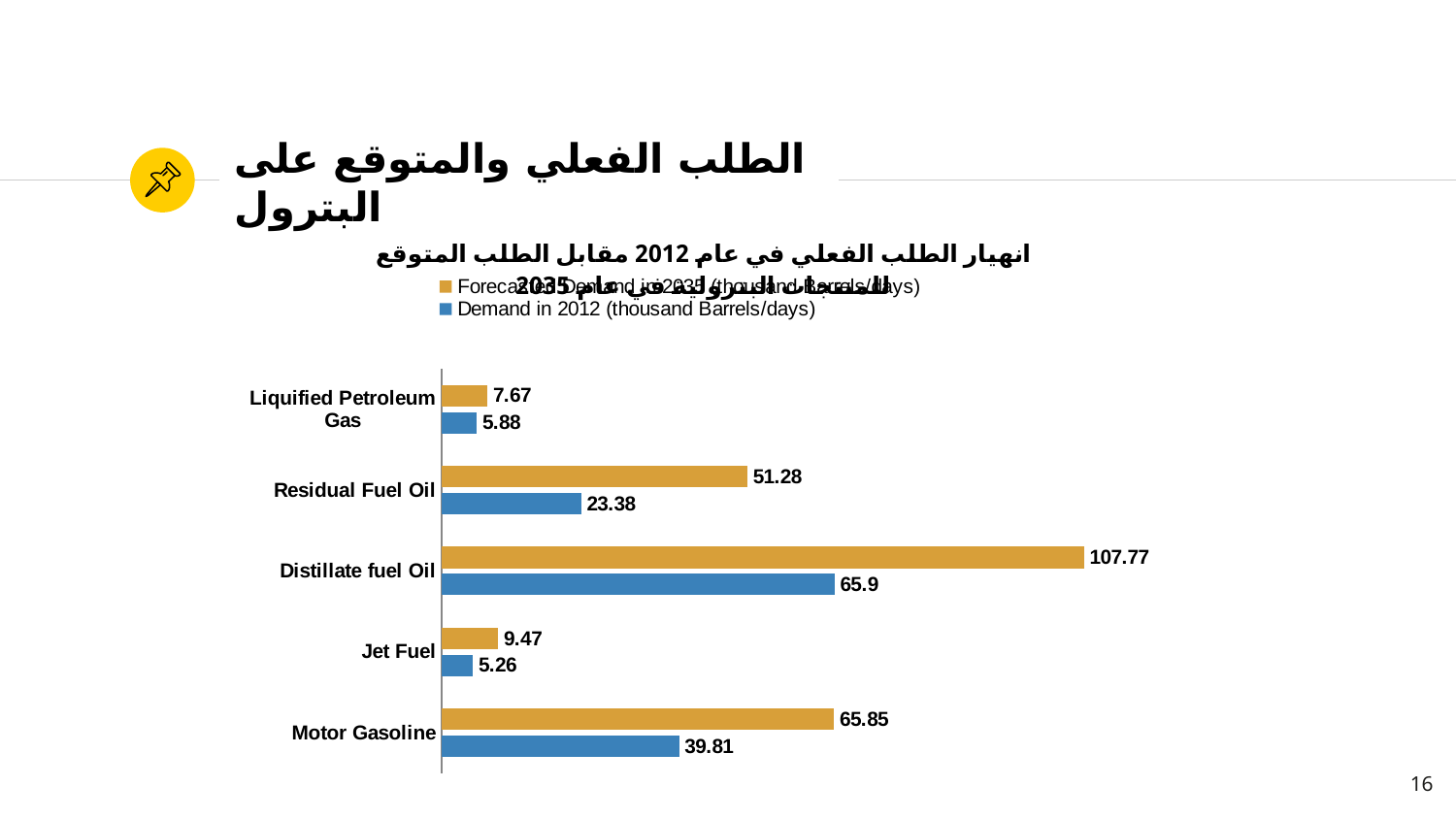
What is the Demand in 2012 value for Distillate fuel Oil? 65.9 What is the difference between the Forecasted Demand in 2035 and the Demand in 2012 for Motor Gasoline? 26.04 Which is larger: the Demand in 2012 for Residual Fuel Oil or the Demand in 2012 for Motor Gasoline? Motor Gasoline How many categories are shown on the chart? 5 Which category has the lowest Demand in 2012? Jet Fuel What type of chart is shown on the slide? Bar chart Which colour represents the Demand in 2012 series? Blue What is the Forecasted Demand in 2035 value for Residual Fuel Oil? 51.28 How many series does the legend list? 2 Which category has the highest Forecasted Demand in 2035? Distillate fuel Oil What is the Forecasted Demand in 2035 value for Jet Fuel? 9.47 What is the Demand in 2012 value for Motor Gasoline? 39.81